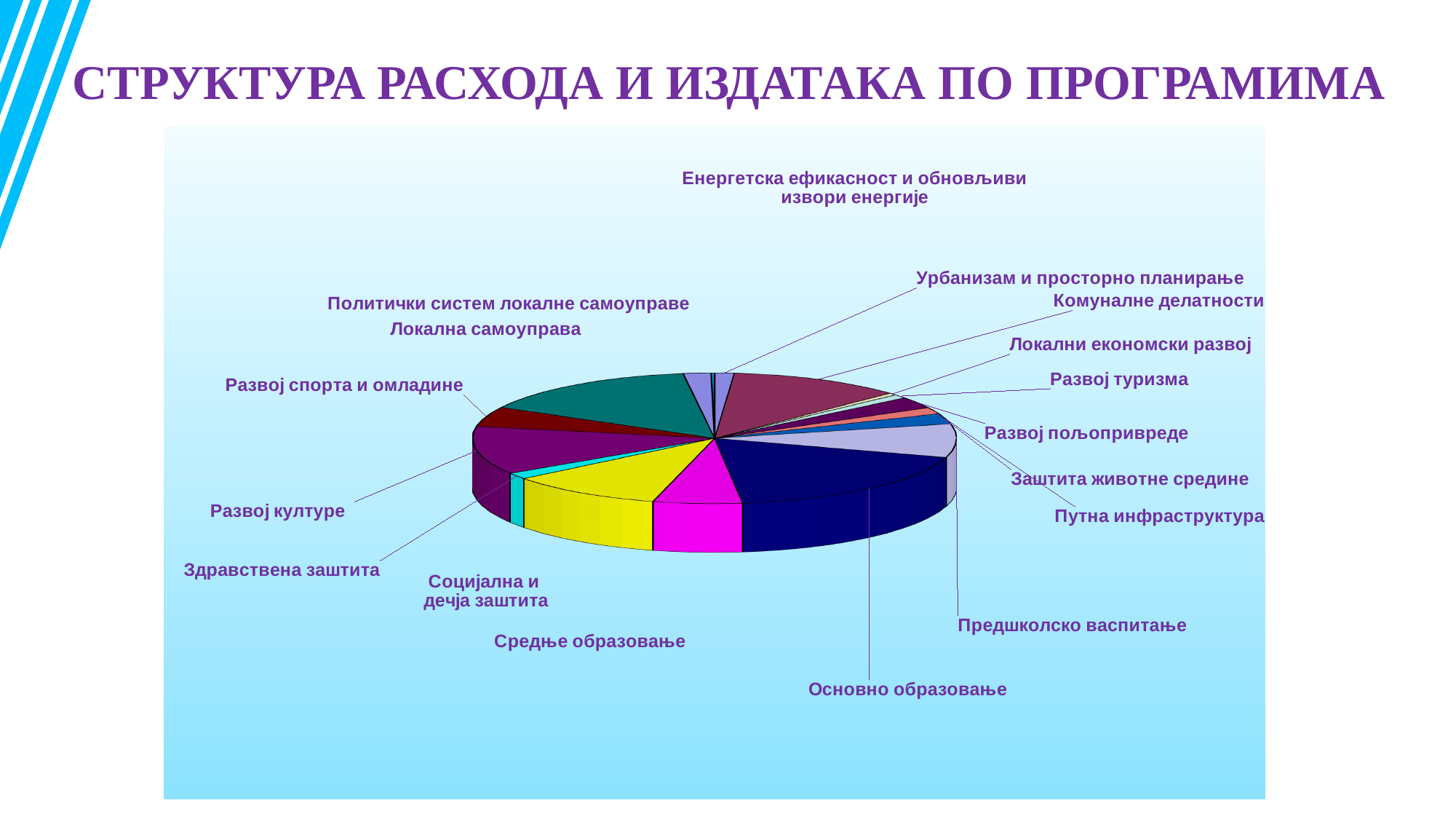
What kind of chart is shown on the slide? Pie chart Is the pie chart drawn in 3D or flat 2D? 3D How many categories (slices) are labelled on the pie chart? 17 Which slice is larger, Локална самоуправа or Развој спорта и омладине? Локална самоуправа What is the title of the slide containing the pie chart? СТРУКТУРА РАСХОДА И ИЗДАТАКА ПО ПРОГРАМИМА Which slice is larger, Средње образовање or Социјална и дечја заштита? Социјална и дечја заштита Which slice is larger, Основно образовање or Предшколско васпитање? Основно образовање Which category has the largest slice of the pie chart? Основно образовање